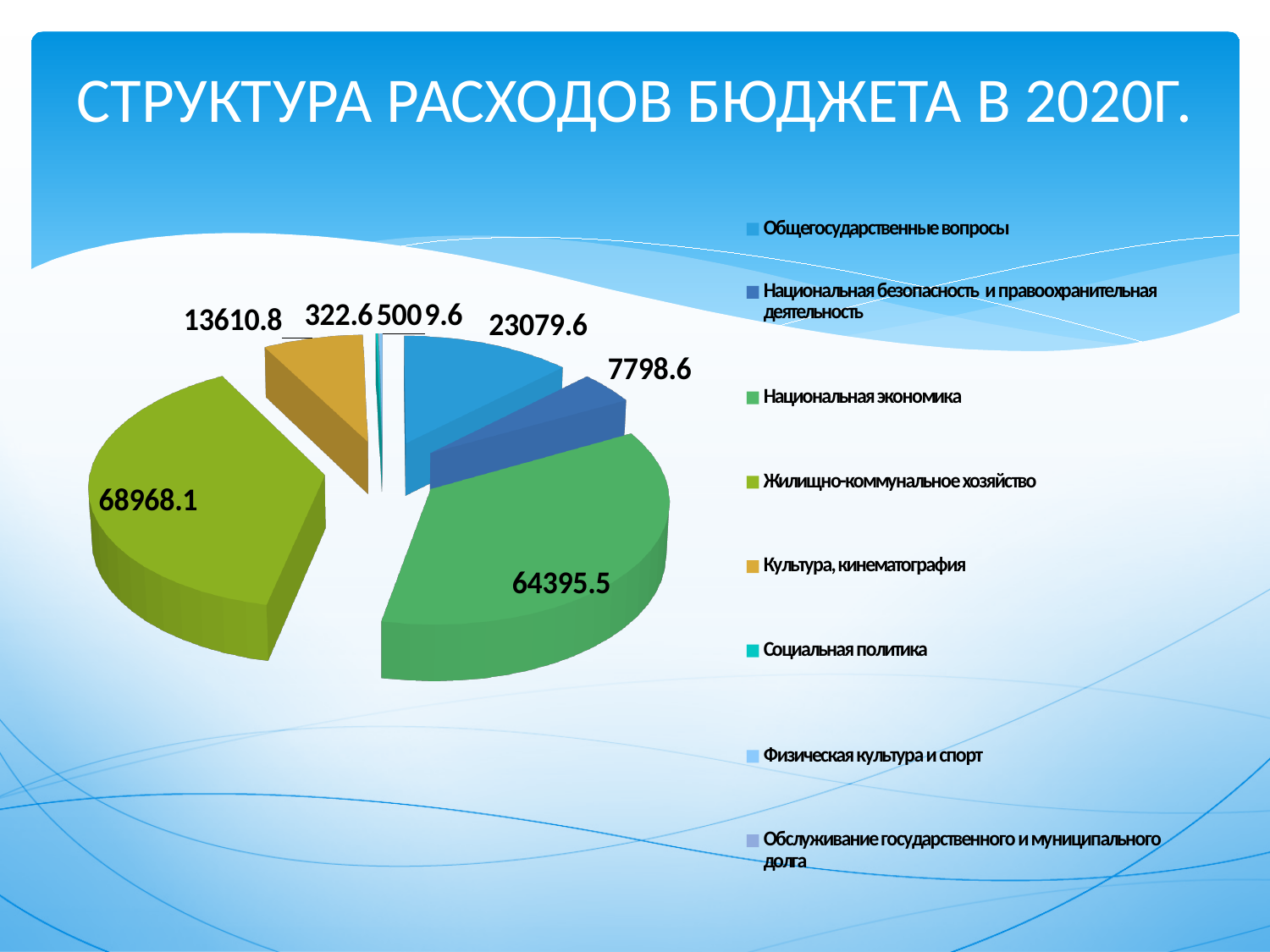
Which is larger: Национальная экономика or Жилищно-коммунальное хозяйство? Жилищно-коммунальное хозяйство What is the value for Культура, кинематография? 13610.8 What is the difference between the values for Общегосударственные вопросы and Национальная безопасность и правоохранительная деятельность? 15281 What is the value for Национальная безопасность и правоохранительная деятельность? 7798.6 Which category has the largest slice of the pie? Жилищно-коммунальное хозяйство What is the value for Общегосударственные вопросы? 23079.6 What kind of chart is shown on the slide? Pie chart What is the title of the chart on the slide? СТРУКТУРА РАСХОДОВ БЮДЖЕТА В 2020Г. What is the value for Жилищно-коммунальное хозяйство? 68968.1 Which category has the smallest slice of the pie? Обслуживание государственного и муниципального долга What is the difference between the values for Жилищно-коммунальное хозяйство and Национальная экономика? 4572.6 How many categories does the legend list? 8